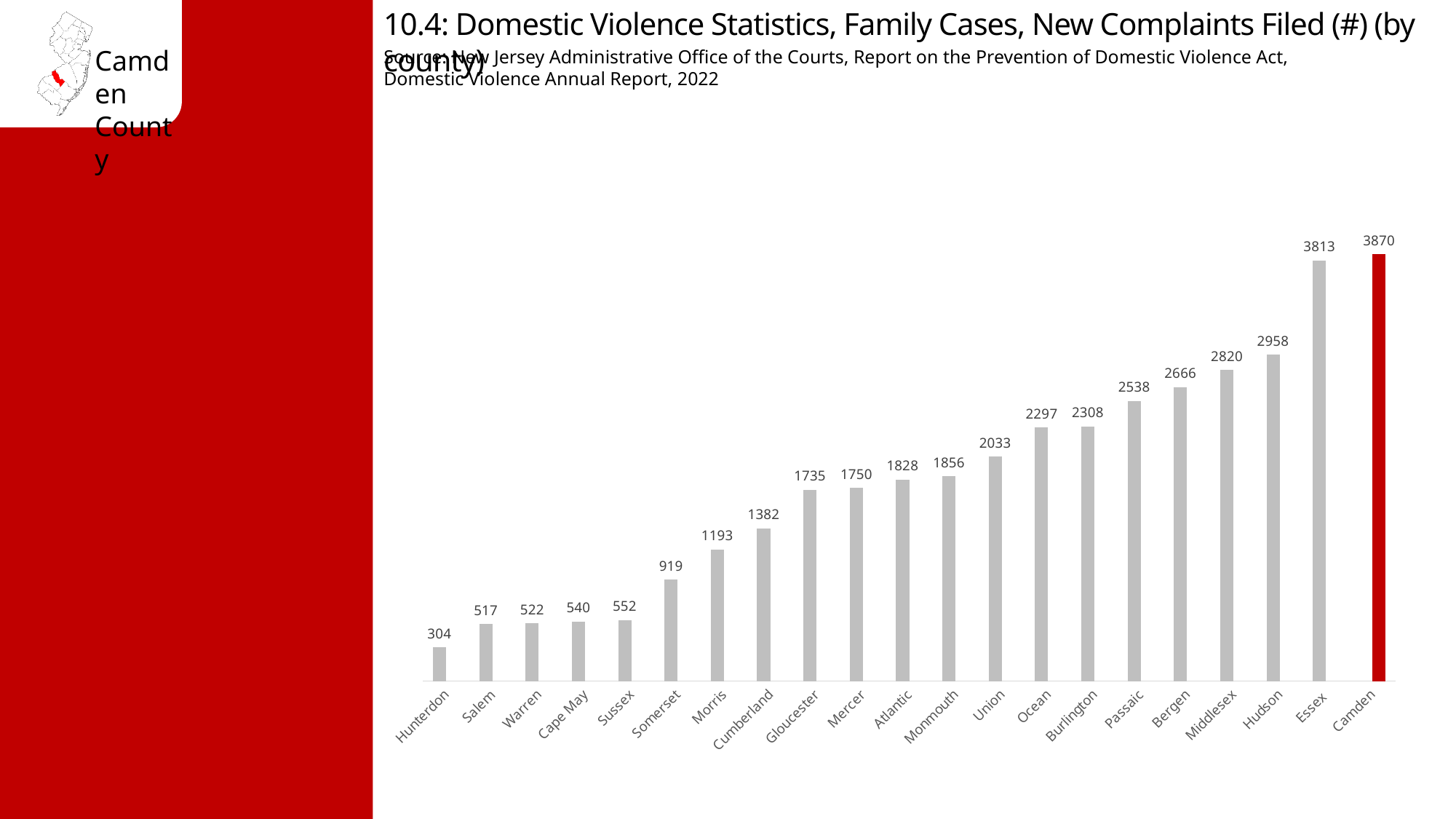
What is the value shown for Hunterdon? 304 What kind of chart is shown on the slide? Bar chart What is the difference between the values for Camden and Essex? 57 How many counties are shown on the chart? 21 Which county has the lowest number of new complaints filed? Hunterdon Which county has the highest number of new complaints filed? Camden What is the number of new domestic violence complaints filed for Camden? 3870 What is the value shown for Gloucester? 1735 Which bar is highlighted in red on the chart? Camden What is the value shown for Burlington? 2308 Which has a larger value, Somerset or Morris? Morris What is the difference between the values for Hudson and Middlesex? 138